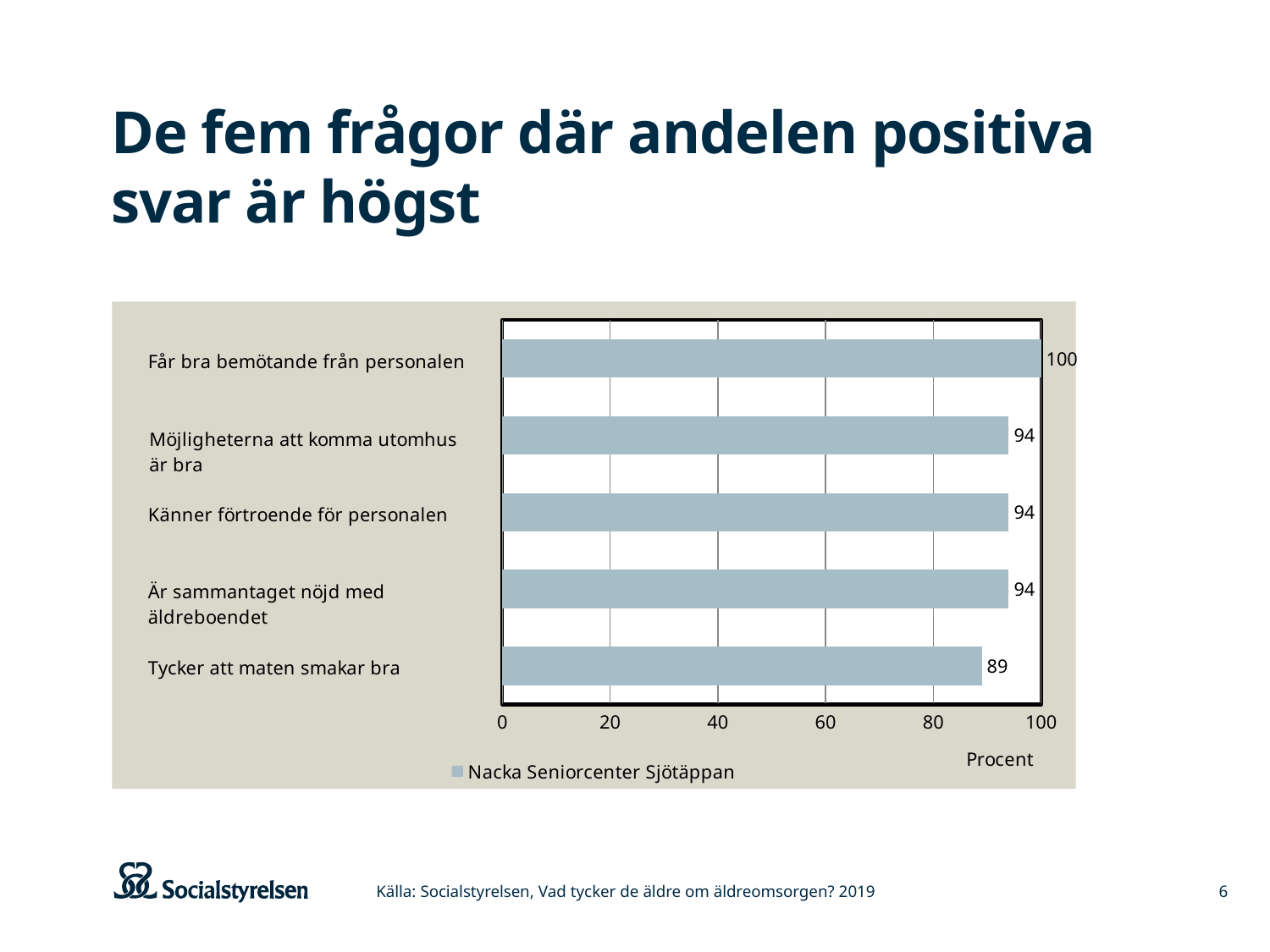
How many categories are shown in the chart? 5 What is the difference between the values for "Möjligheterna att komma utomhus är bra" and "Tycker att maten smakar bra"? 5 What is the difference between the values for "Får bra bemötande från personalen" and "Tycker att maten smakar bra"? 11 Which is larger, the value for "Är sammantaget nöjd med äldreboendet" or the value for "Tycker att maten smakar bra"? Är sammantaget nöjd med äldreboendet Is the value for "Tycker att maten smakar bra" greater or less than 80? greater What is the value for "Får bra bemötande från personalen"? 100 Which category has the highest value? Får bra bemötande från personalen What is the value for "Känner förtroende för personalen"? 94 Which category has the lowest value? Tycker att maten smakar bra What series name does the legend show? Nacka Seniorcenter Sjötäppan What is the value for "Tycker att maten smakar bra"? 89 What kind of chart is shown on the slide? Bar chart